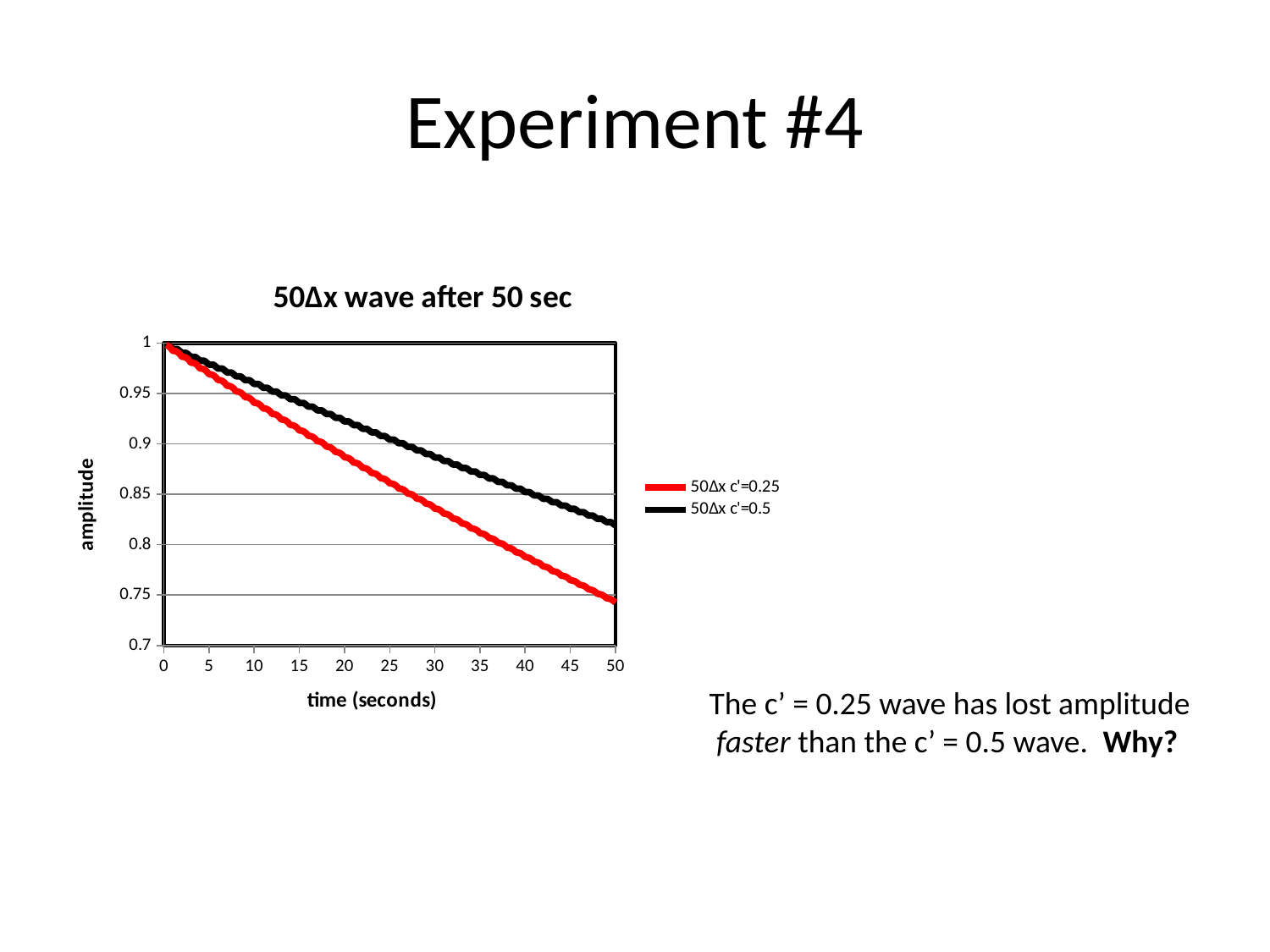
How many series does the legend list? 2 What is the label of the x axis? time (seconds) What is the title of the chart? 50Δx wave after 50 sec Does the amplitude of the 50Δx c'=0.25 series rise or fall as time increases? fall Does the amplitude of the 50Δx c'=0.5 series rise or fall as time increases? fall What kind of chart is shown on the slide? line chart Is the amplitude of the 50Δx c'=0.25 series at time 50 greater or less than 0.75? less Is the amplitude of the 50Δx c'=0.5 series at time 10 greater or less than 0.95? less At time 50, which series has the larger amplitude, 50Δx c'=0.25 or 50Δx c'=0.5? 50Δx c'=0.5 Is the amplitude of the 50Δx c'=0.25 series at time 20 greater or less than 0.9? less